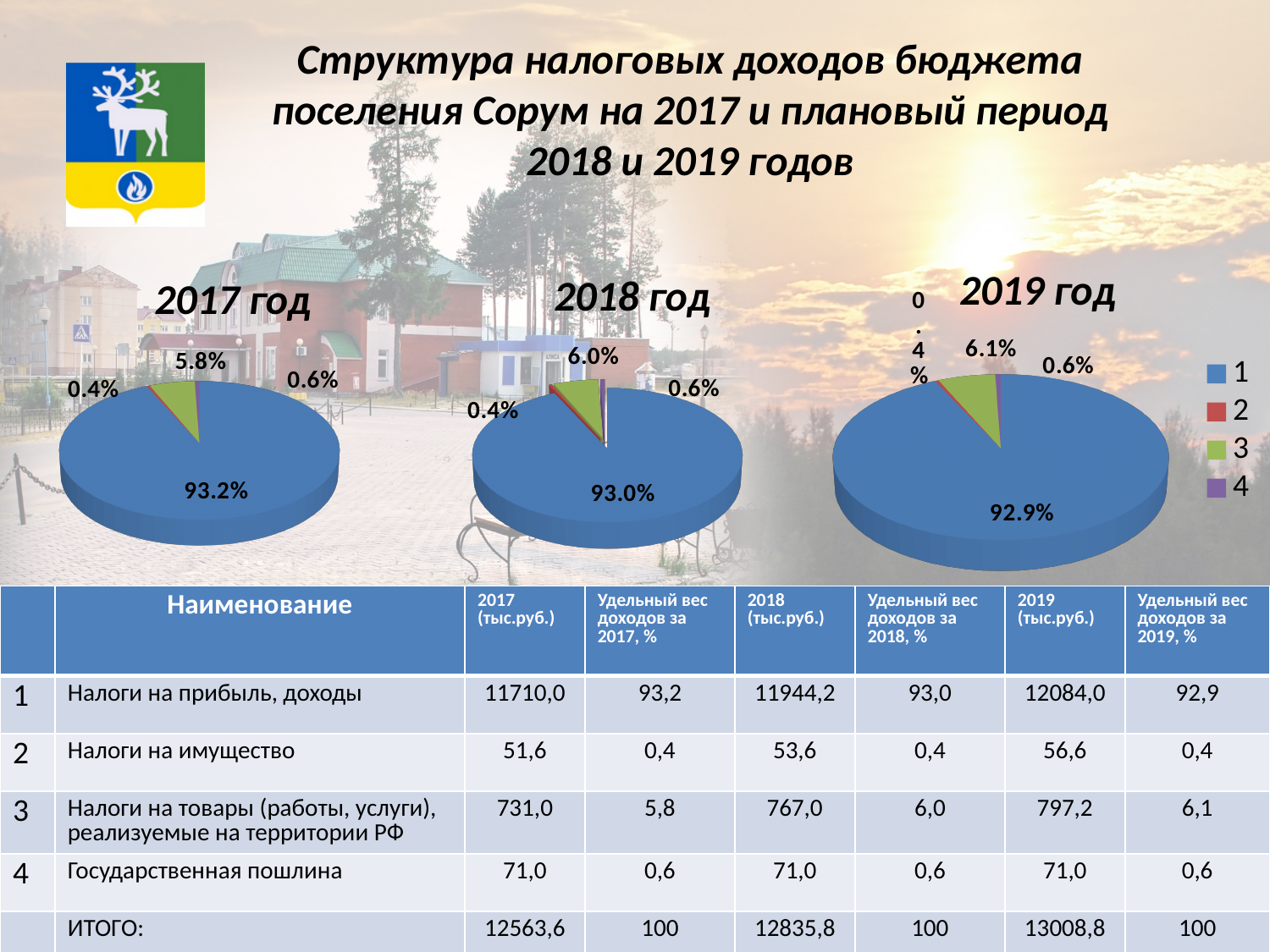
In the 2019 год pie chart, what is the share of the largest slice? 92.9% In the 2017 год pie chart, what is the share of the largest slice? 93.2% In the 2019 год pie chart, what is the share of the green slice? 6.1% In the 2018 год pie chart, what is the share of the green slice? 6.0% Which is larger: the green slice in the 2017 год chart or the green slice in the 2019 год chart? 2019 год How many pie charts are shown on the slide? 3 In the 2017 год pie chart, what is the share of the green slice? 5.8% How many entries does the legend shared by the pie charts list? 4 What kind of chart is used for the 2017 год chart? pie chart What is the difference between the largest slice in the 2017 год chart and the largest slice in the 2019 год chart? 0.3% In the 2018 год pie chart, what is the share of the largest slice? 93.0% In the 2019 год pie chart, what is the share of the smallest slice? 0.4%